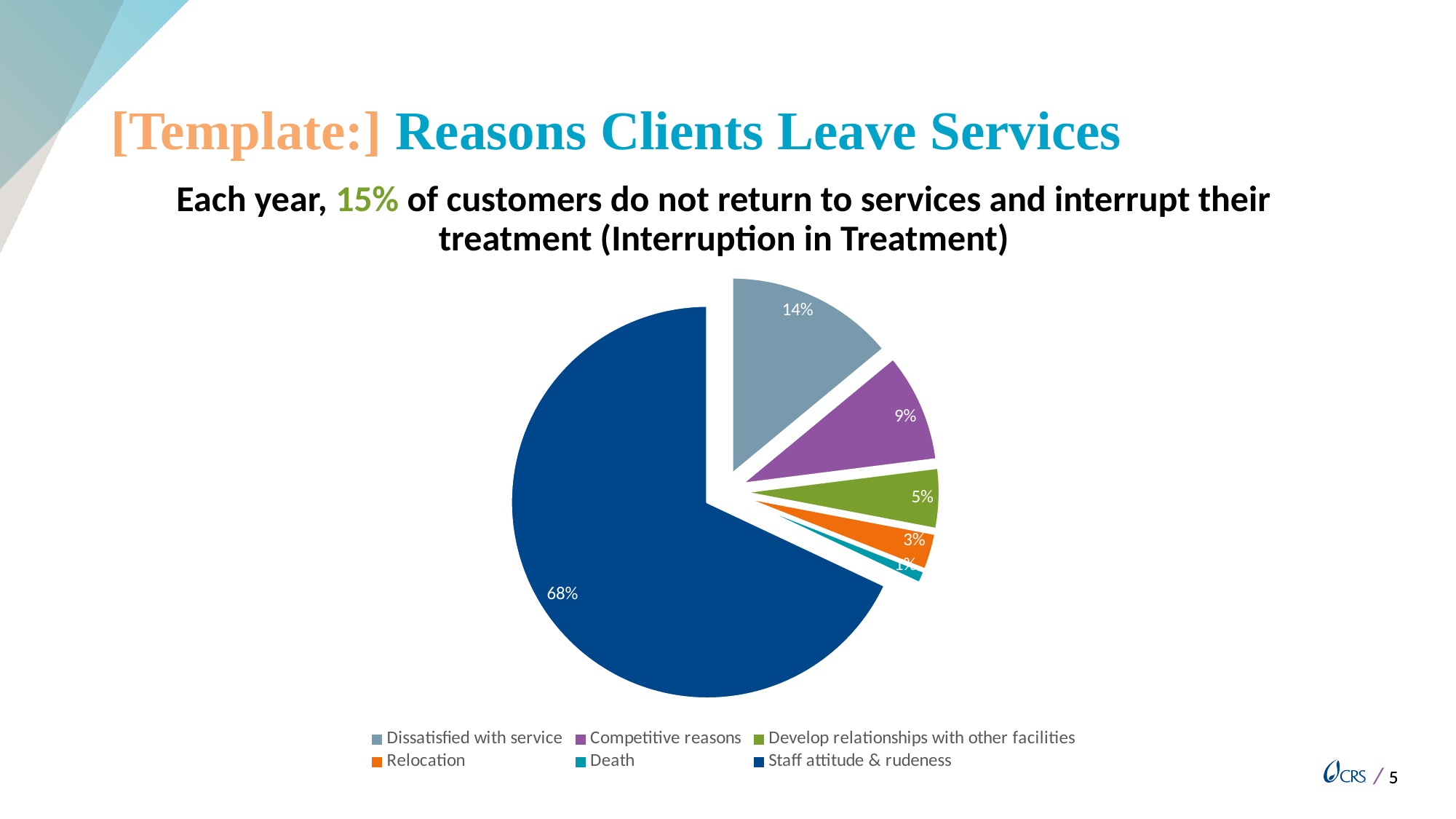
Which is larger, the slice for Develop relationships with other facilities or the slice for Relocation? Develop relationships with other facilities How many slices does the pie chart have? 6 What share of the pie does the Death slice represent? 1% What percentage of the pie is labelled for Staff attitude & rudeness? 68% What colour is the slice for Staff attitude & rudeness? Dark blue What kind of chart is shown on the slide? Pie chart Which reason has the largest slice of the pie? Staff attitude & rudeness What percentage of the pie is labelled for Relocation? 3% What percentage of the pie is labelled for Dissatisfied with service? 14% What percentage of the pie is labelled for Competitive reasons? 9% What is the difference in percentage points between Dissatisfied with service and Competitive reasons? 5 Which reason has the smallest slice of the pie? Death